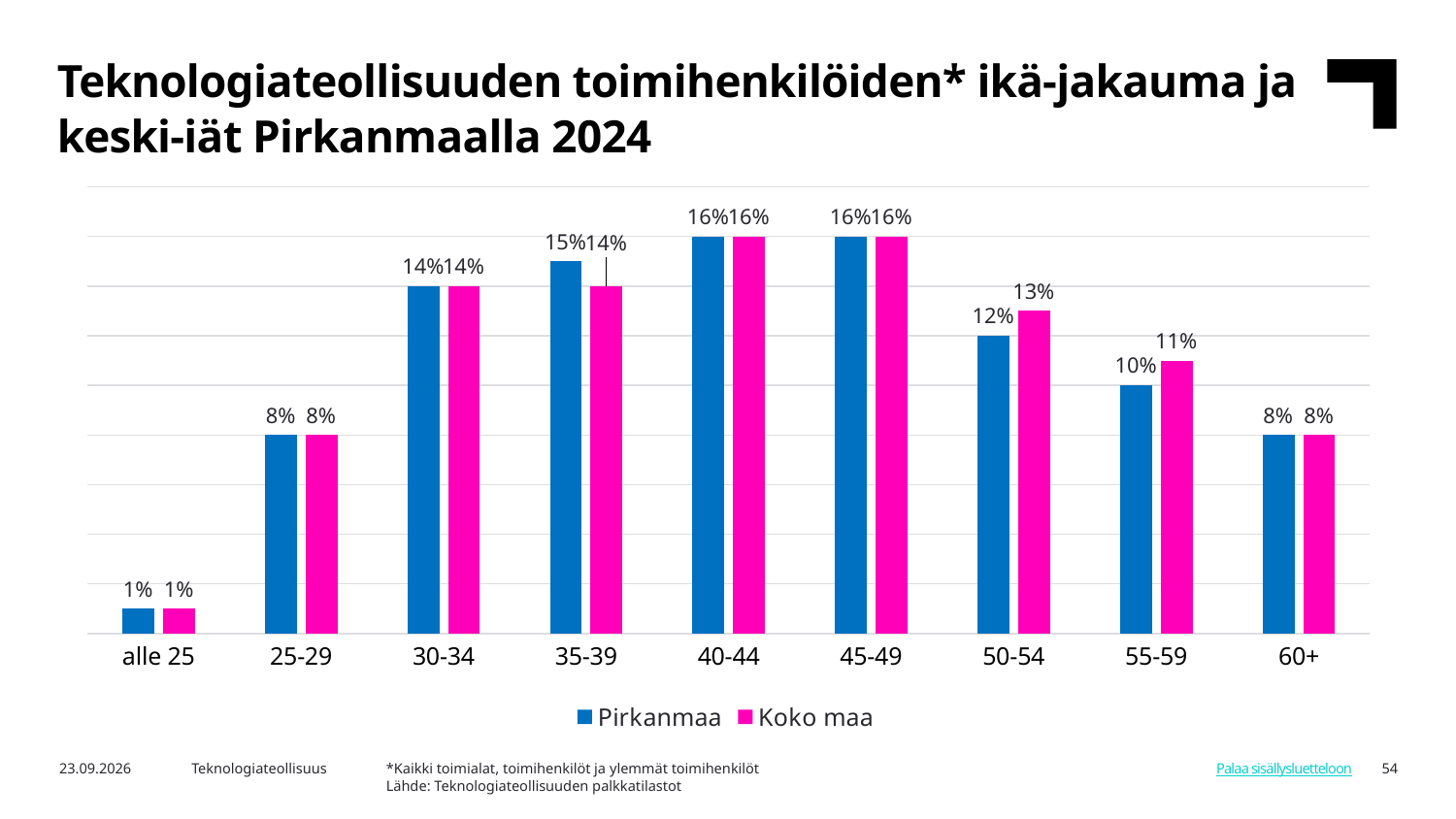
What is the value for Koko maa in the 50-54 age group? 13% What is the difference between the Pirkanmaa values for 40-44 and 25-29? 8% In the 50-54 age group, which series has the larger value, Pirkanmaa or Koko maa? Koko maa How many series does the legend list? 2 What is the value for Pirkanmaa in the 55-59 age group? 10% Which is larger for Pirkanmaa: the value for 30-34 or the value for 60+? 30-34 Which age group has the lowest value for Pirkanmaa? alle 25 What kind of chart is shown on the slide? Bar chart What is the difference between the Koko maa and Pirkanmaa values in the 55-59 age group? 1% What is the value for Pirkanmaa in the 35-39 age group? 15% How many age groups are shown on the x axis? 9 What is the value for Koko maa in the 30-34 age group? 14%